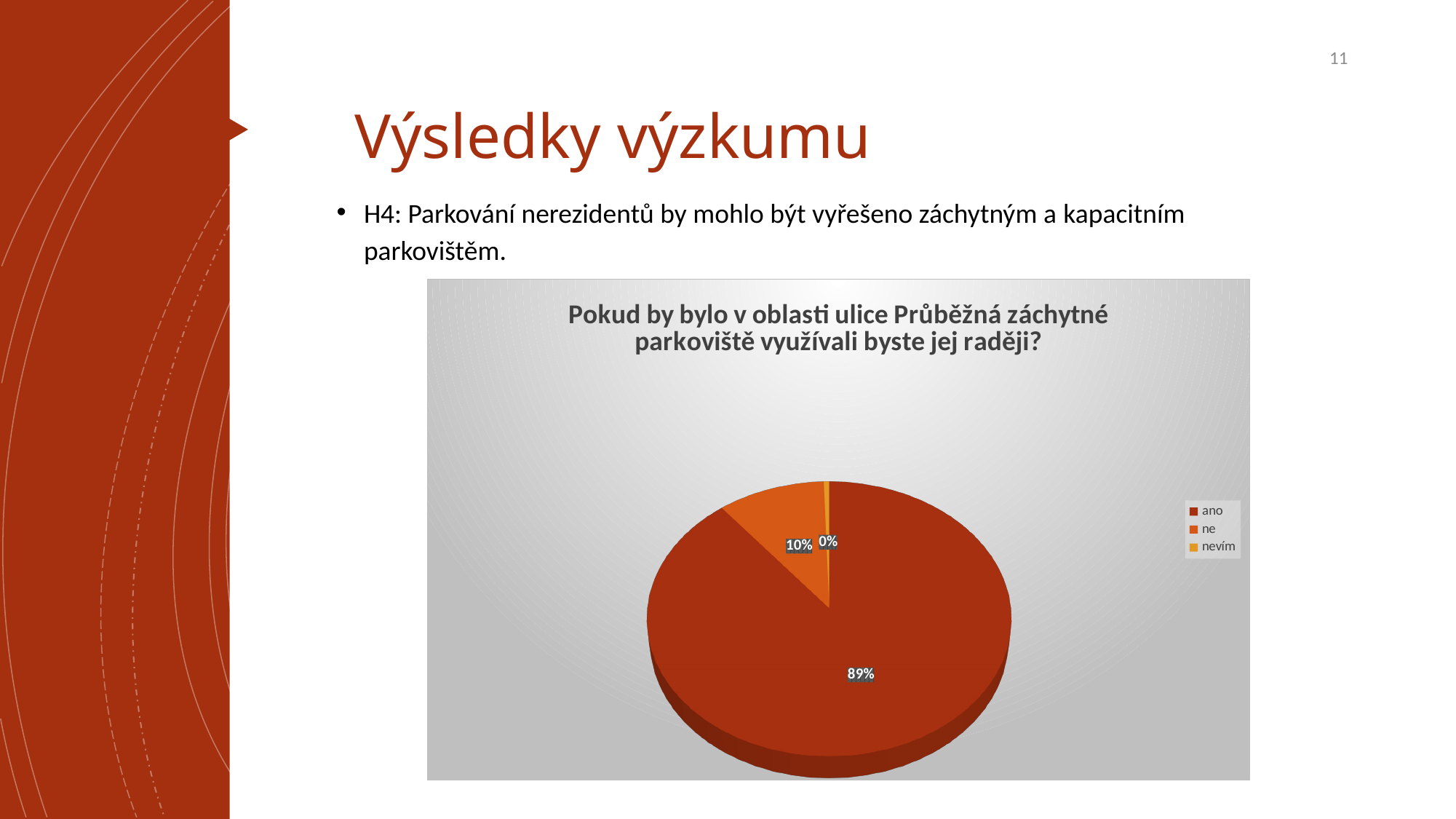
What percentage of respondents answered "ne"? 10% Which slice is larger, "ne" or "nevím"? ne What kind of chart is shown on the slide? pie chart Which answer has the smallest share of the pie? nevím Which answer has the largest share of the pie? ano What is the difference in percentage points between the "ano" and "ne" slices? 79 What is the title of the chart? Pokud by bylo v oblasti ulice Průběžná záchytné parkoviště využívali byste jej raději? What percentage of respondents answered "nevím"? 0% What percentage of respondents answered "ano"? 89% How many categories does the legend list? 3 Which legend entry is shown in the darkest red colour? ano